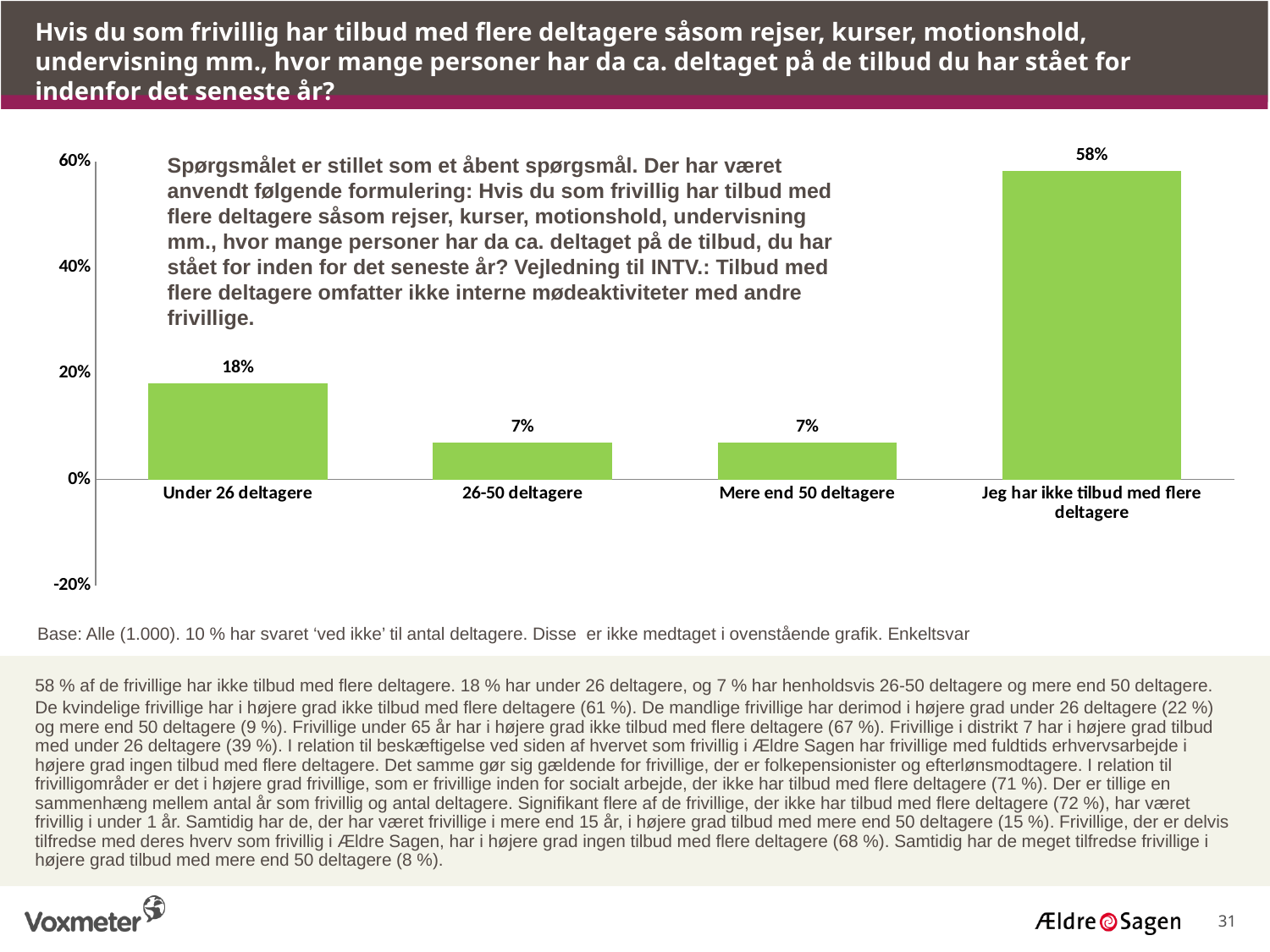
Which is larger, 'Under 26 deltagere' or 'Mere end 50 deltagere'? Under 26 deltagere What kind of chart is shown on the slide? bar chart What is the difference between 'Under 26 deltagere' and '26-50 deltagere'? 11% How many categories are shown on the x axis? 4 What is the value for 'Jeg har ikke tilbud med flere deltagere'? 58% What is the value for 'Mere end 50 deltagere'? 7% What is the difference between 'Jeg har ikke tilbud med flere deltagere' and 'Under 26 deltagere'? 40% What is the value for '26-50 deltagere'? 7% Which category has the highest value? Jeg har ikke tilbud med flere deltagere Is the value for 'Jeg har ikke tilbud med flere deltagere' greater or less than 40%? greater What colour are the bars in the chart? green What is the value for 'Under 26 deltagere'? 18%